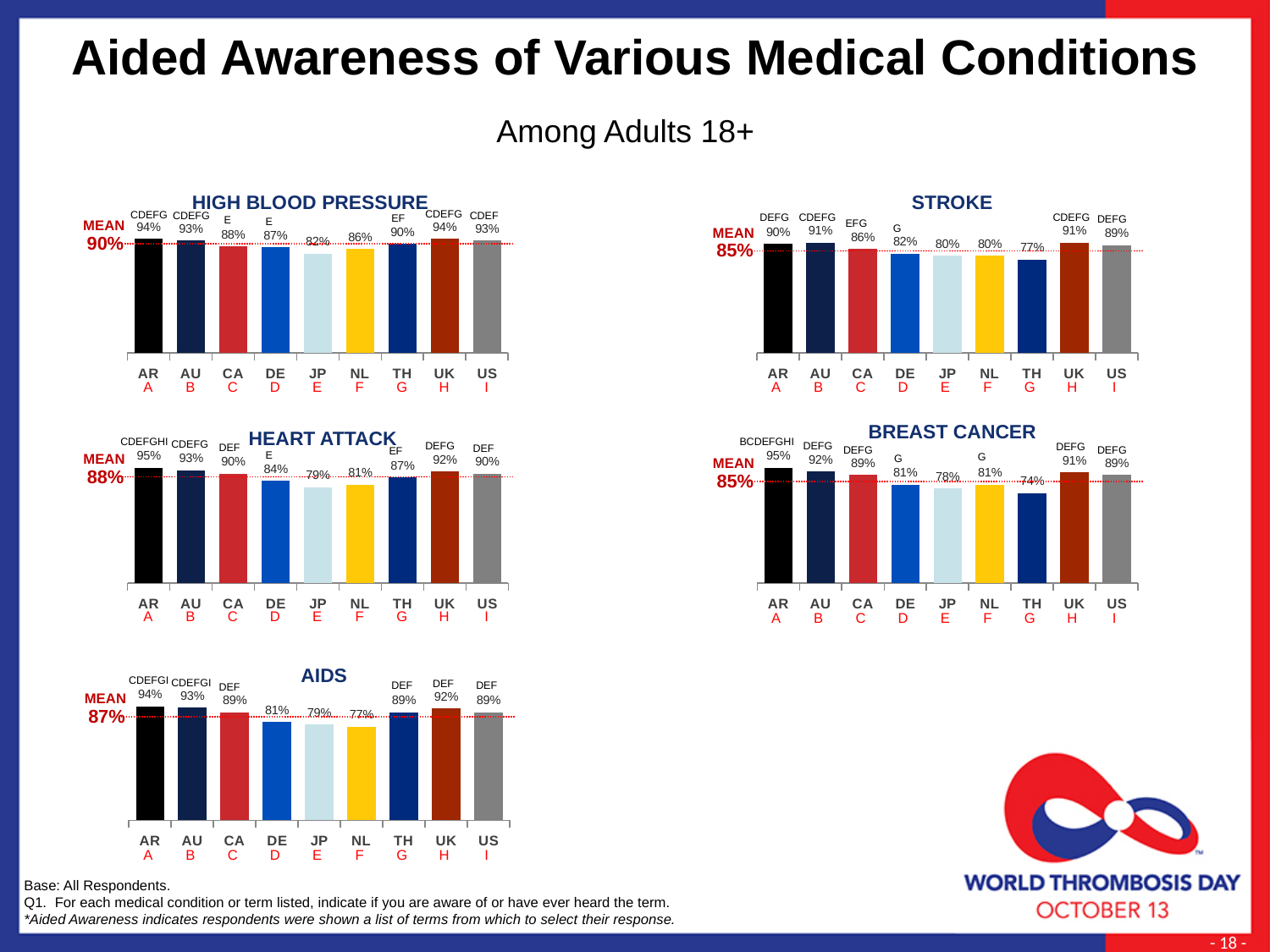
In the HEART ATTACK chart, what is the difference between the values for AR and JP? 16% What is the MEAN value shown for the HEART ATTACK chart? 88% In the AIDS chart, which country has the lowest value? NL In the HEART ATTACK chart, which country has the highest value? AR In the STROKE chart, which country has the lowest value? TH In the HIGH BLOOD PRESSURE chart, what is the value for JP? 82% In the STROKE chart, what is the value for CA? 86% How many countries are shown in the HIGH BLOOD PRESSURE chart? 9 In the BREAST CANCER chart, what is the value for TH? 74% What type of chart is the STROKE chart? Bar chart In the AIDS chart, what is the value for DE? 81% In the BREAST CANCER chart, which is larger, the value for AU or the value for UK? AU